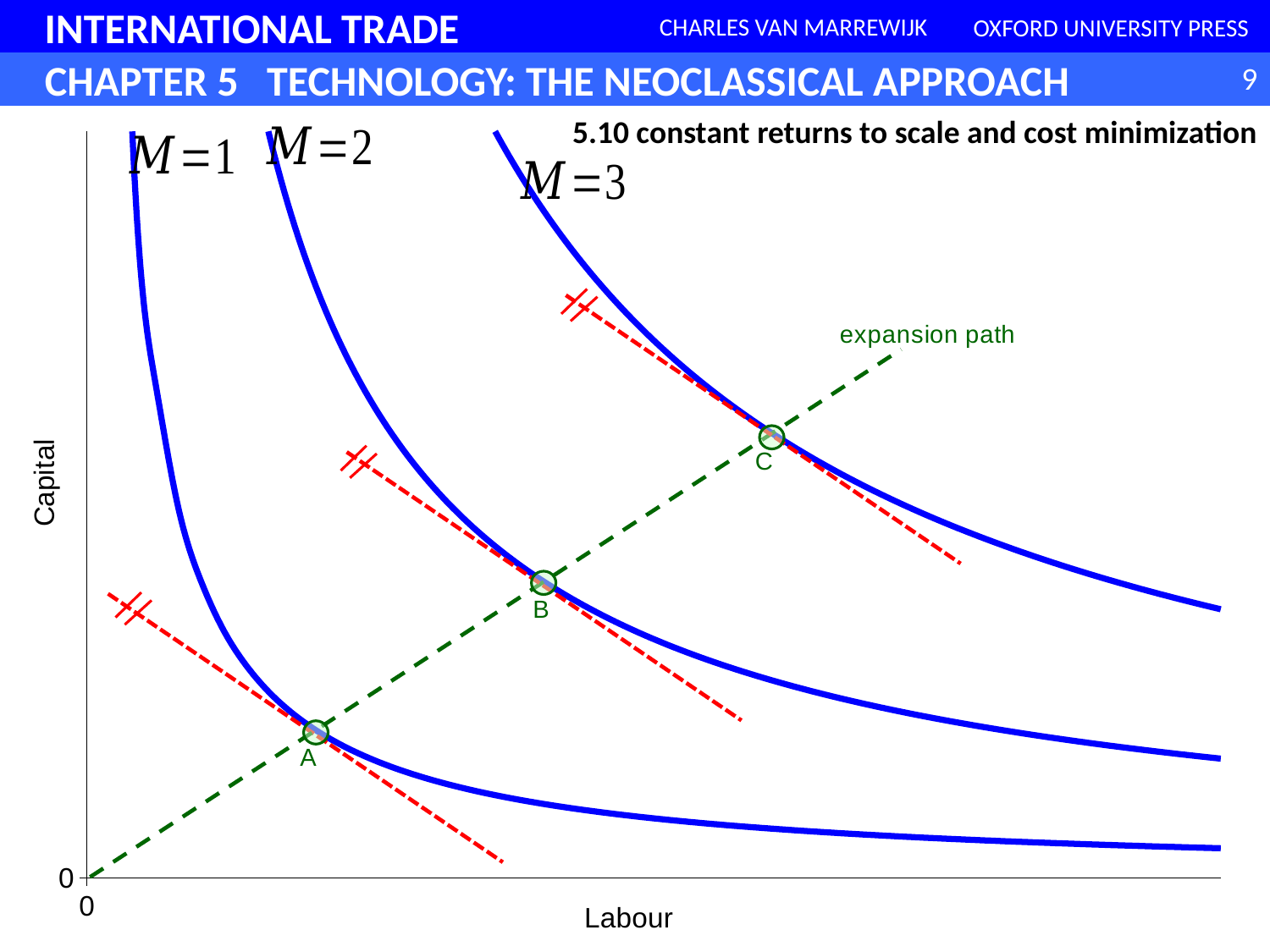
Which labelled point has the highest level of Capital: A, B or C? C Which point uses more Labour, B or C? C Which isoquant is closest to the origin? M=1 How many labelled points (circled) lie on the expansion path? 3 What is the label of the green dashed line in the chart? expansion path What is the title of the chart on the slide? 5.10 constant returns to scale and cost minimization How many blue isoquant curves are drawn on the chart? 3 What label is on the horizontal axis of the chart? Labour Which isoquant is farthest from the origin: M=1, M=2 or M=3? M=3 Which labelled point has the lowest level of Labour: A, B or C? A Along each blue isoquant, does Capital rise or fall as Labour increases? fall What label is on the vertical axis of the chart? Capital